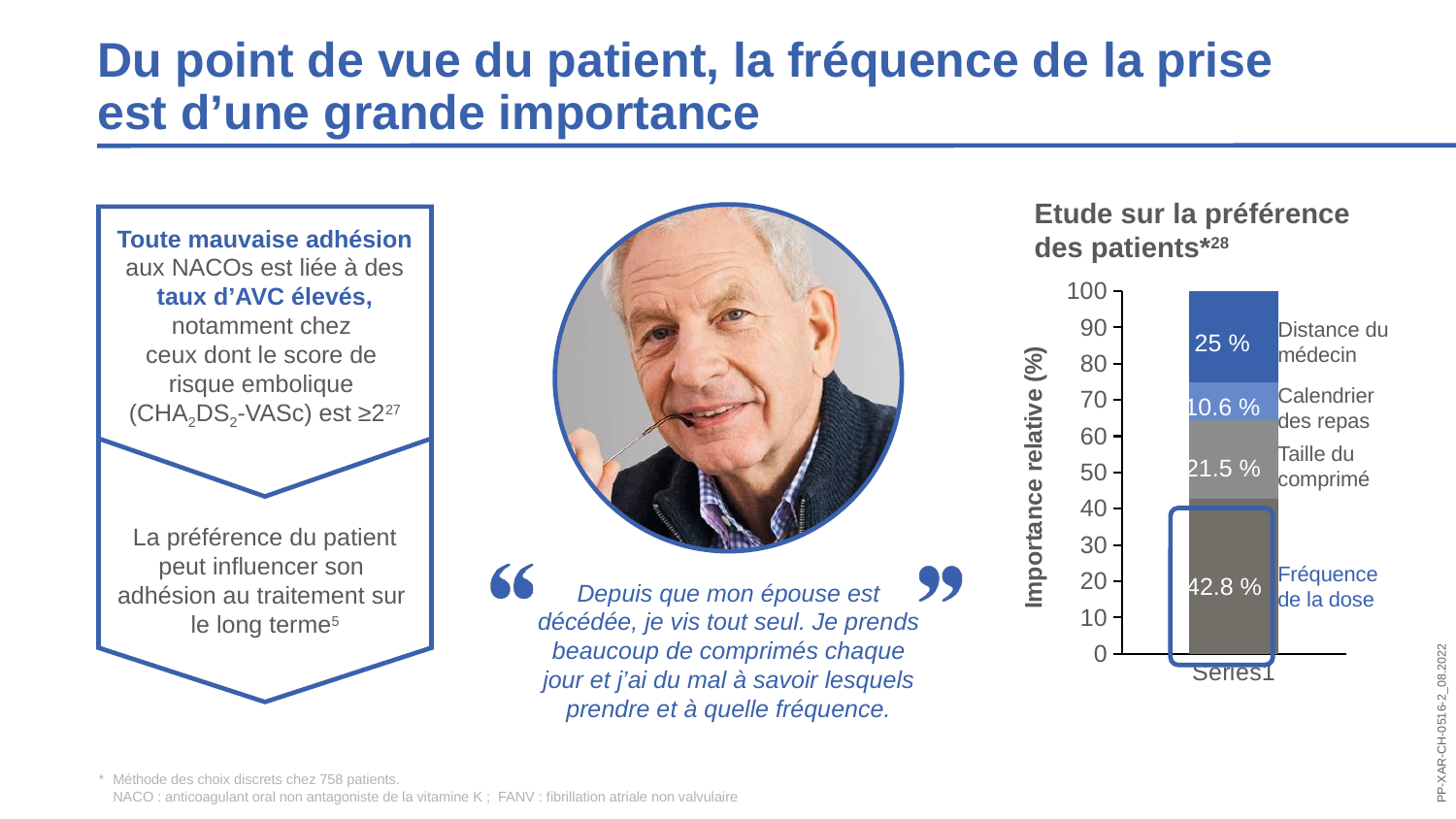
What kind of chart is shown on the slide? Stacked bar chart Which is larger, the value for "Taille du comprimé" or the value for "Calendrier des repas"? Taille du comprimé What is the difference between the values for "Fréquence de la dose" and "Distance du médecin"? 17.8 % What is the relative importance value for "Distance du médecin"? 25 % Which segment of the stacked bar has the lowest relative importance? Calendrier des repas What is the relative importance value for "Calendrier des repas"? 10.6 % How many segments make up the stacked bar? 4 Which segment of the stacked bar has the highest relative importance? Fréquence de la dose What is the relative importance value for "Taille du comprimé"? 21.5 % What is the title of the chart? Etude sur la préférence des patients*28 What is the relative importance value for "Fréquence de la dose"? 42.8 % What is the label of the y axis of the chart? Importance relative (%)